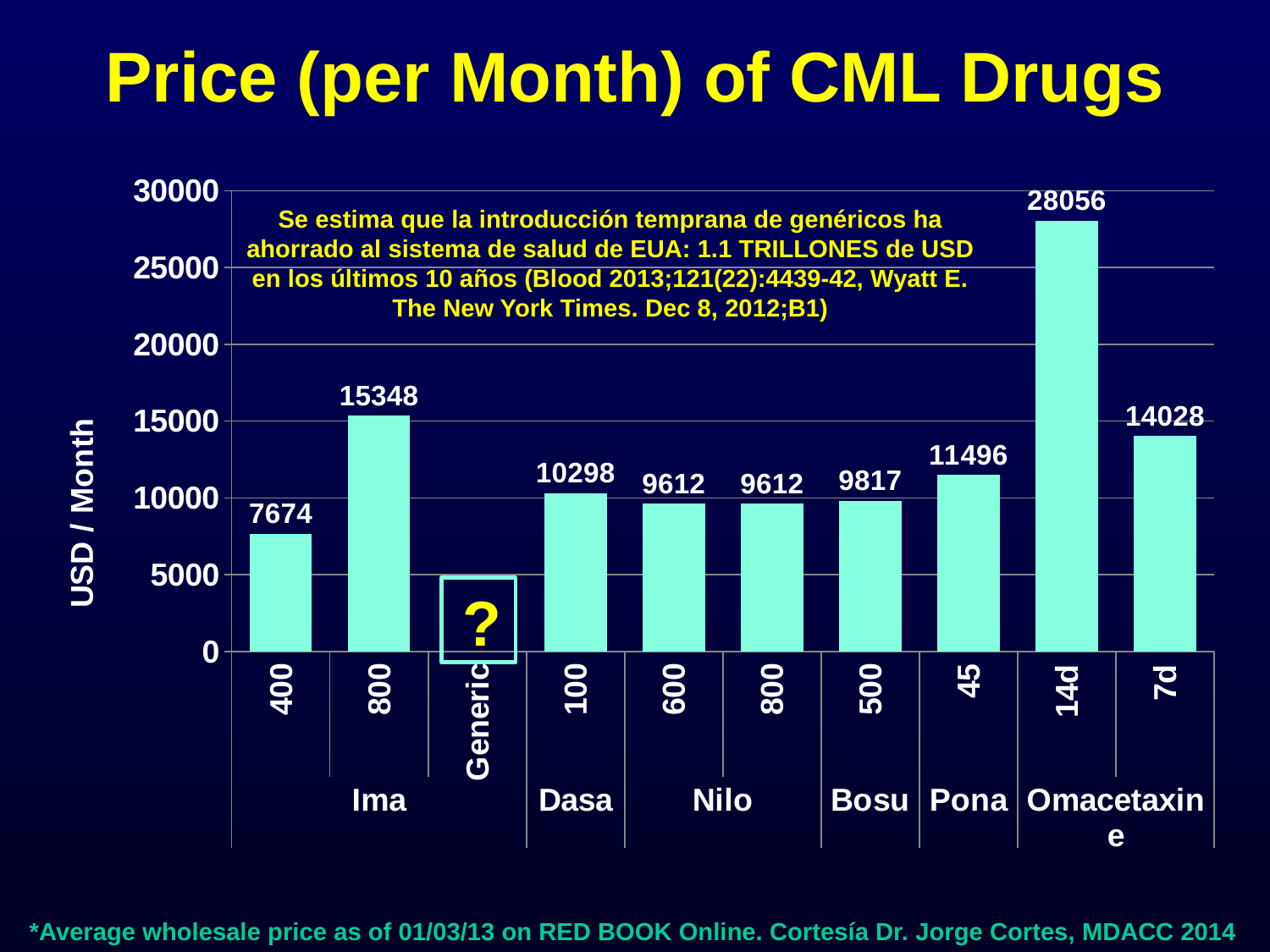
What is the price per month for Ima 800? 15348 Which labelled bar has the lowest price per month? Ima 400 What is the price per month for Omacetaxine 14d? 28056 What is the difference in price per month between Ima 800 and Ima 400? 7674 What is the price per month for Dasa 100? 10298 Is the price per month for Pona 45 greater or less than 10000? greater What is the price per month for Pona 45? 11496 What kind of chart is shown on the slide? bar chart What is the difference in price per month between Omacetaxine 14d and Omacetaxine 7d? 14028 Which category has the highest price per month? Omacetaxine 14d Which is larger, the price per month for Bosu 500 or for Nilo 600? Bosu 500 What is the label of the y axis? USD / Month